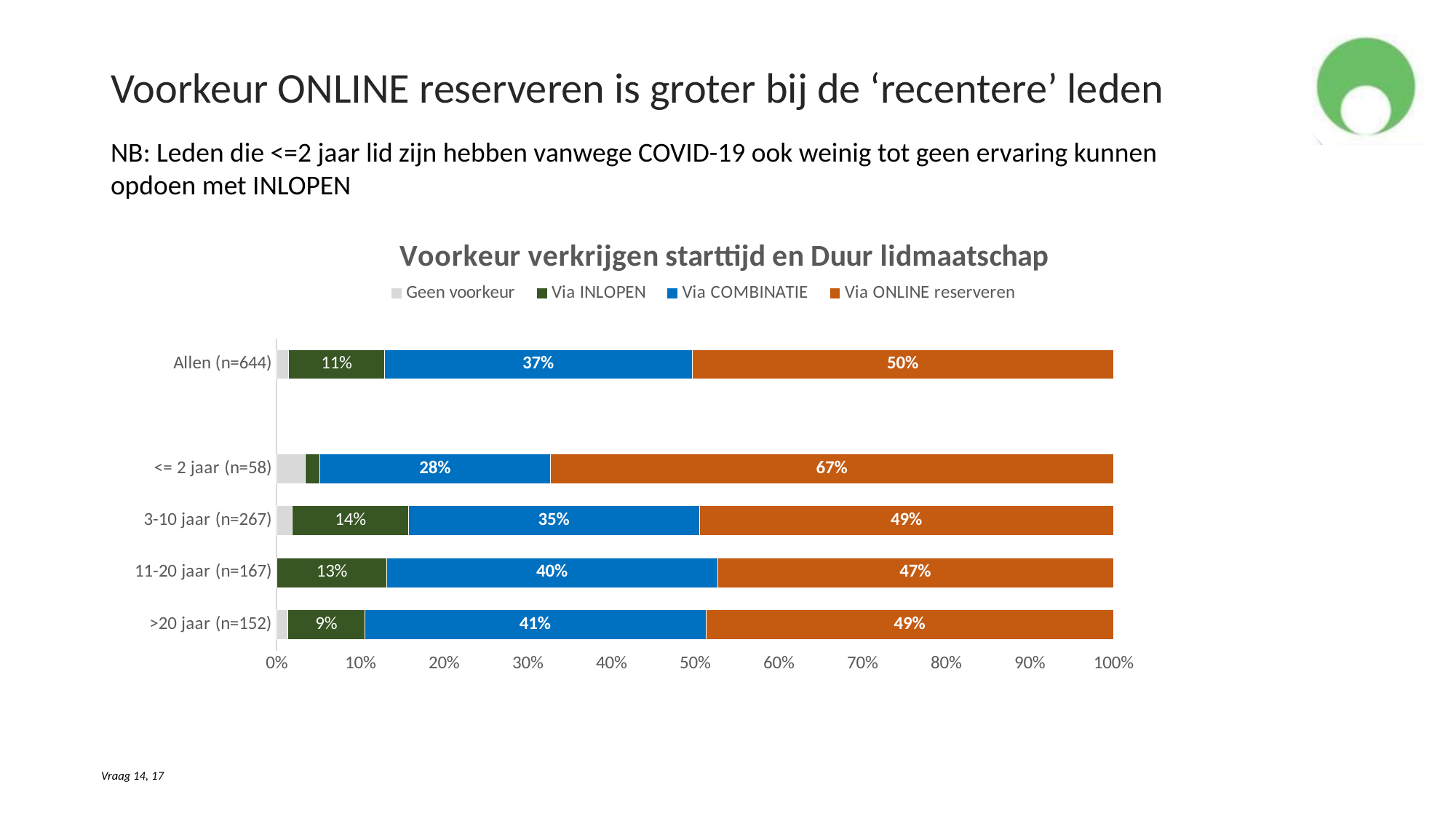
What kind of chart is shown on the slide? Stacked bar chart What is the value for Via ONLINE reserveren for the <= 2 jaar (n=58) category? 67% What is the value for Via ONLINE reserveren for Allen (n=644)? 50% What is the value for Via INLOPEN for the 3-10 jaar (n=267) category? 14% Which is larger: the Via INLOPEN value for 3-10 jaar (n=267) or for >20 jaar (n=152)? 3-10 jaar (n=267) How many series does the legend list? 4 Which category has the highest value for Via ONLINE reserveren? <= 2 jaar (n=58) How many categories are shown on the y axis of the chart? 5 What is the difference between the Via ONLINE reserveren values for <= 2 jaar (n=58) and 11-20 jaar (n=167)? 20% What is the value for Via COMBINATIE for the >20 jaar (n=152) category? 41% Which category has the lowest value for Via COMBINATIE? <= 2 jaar (n=58) Is the Via ONLINE reserveren value for 11-20 jaar (n=167) greater or less than 40%? greater